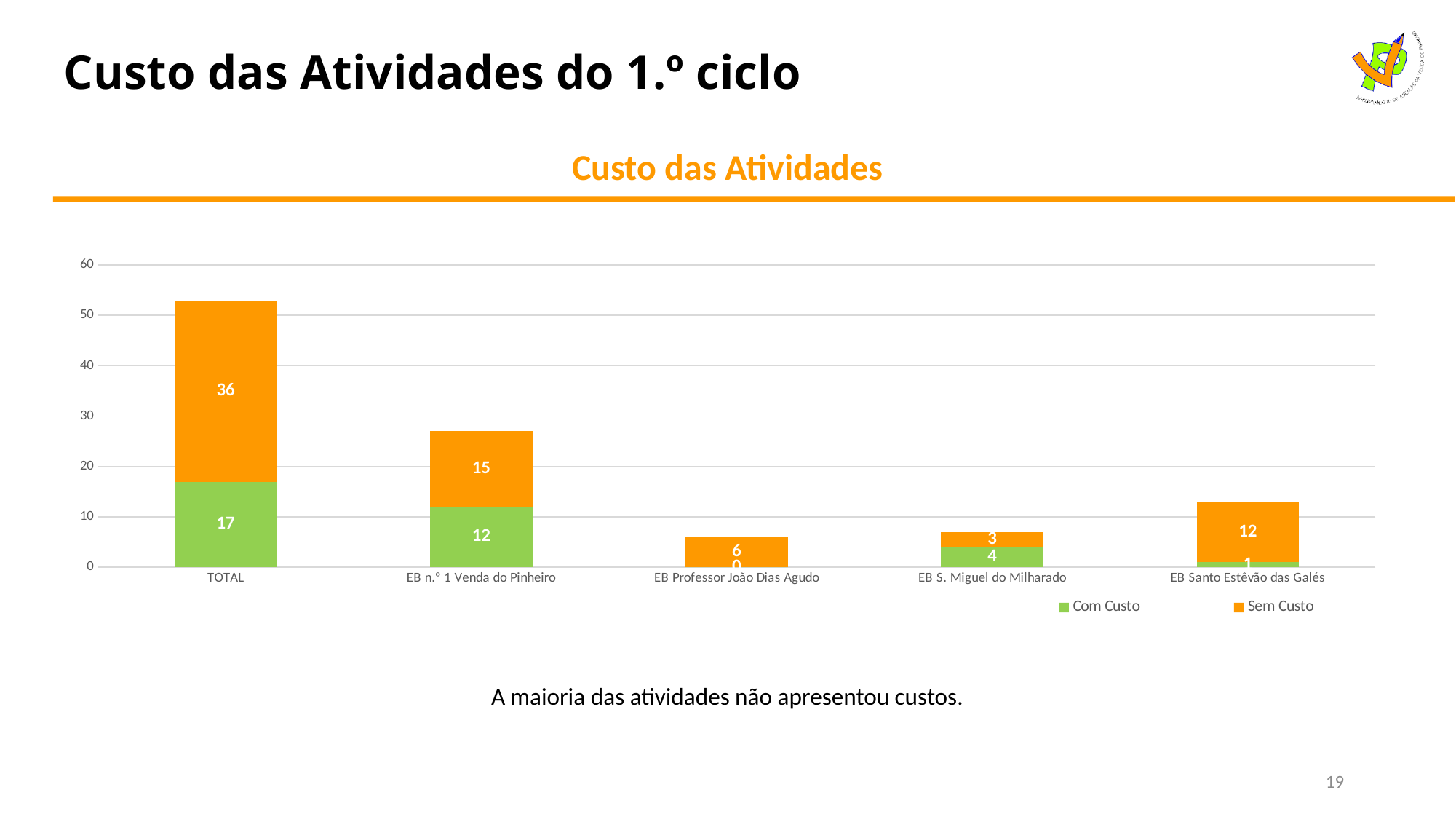
Which school (excluding TOTAL) has the highest Sem Custo value? EB n.º 1 Venda do Pinheiro Which is larger for EB S. Miguel do Milharado, Com Custo or Sem Custo? Com Custo What is the Com Custo value for EB n.º 1 Venda do Pinheiro? 12 How many series does the legend list? 2 What type of chart is shown on the slide? Stacked bar chart What is the Com Custo value for EB Professor João Dias Agudo? 0 What is the total of the stacked bar for EB n.º 1 Venda do Pinheiro? 27 What is the Sem Custo value for TOTAL? 36 Which school (excluding TOTAL) has the lowest Com Custo value? EB Professor João Dias Agudo What is the Sem Custo value for EB Santo Estêvão das Galés? 12 How many categories are shown on the x axis? 5 What is the difference between the Sem Custo and Com Custo values for TOTAL? 19